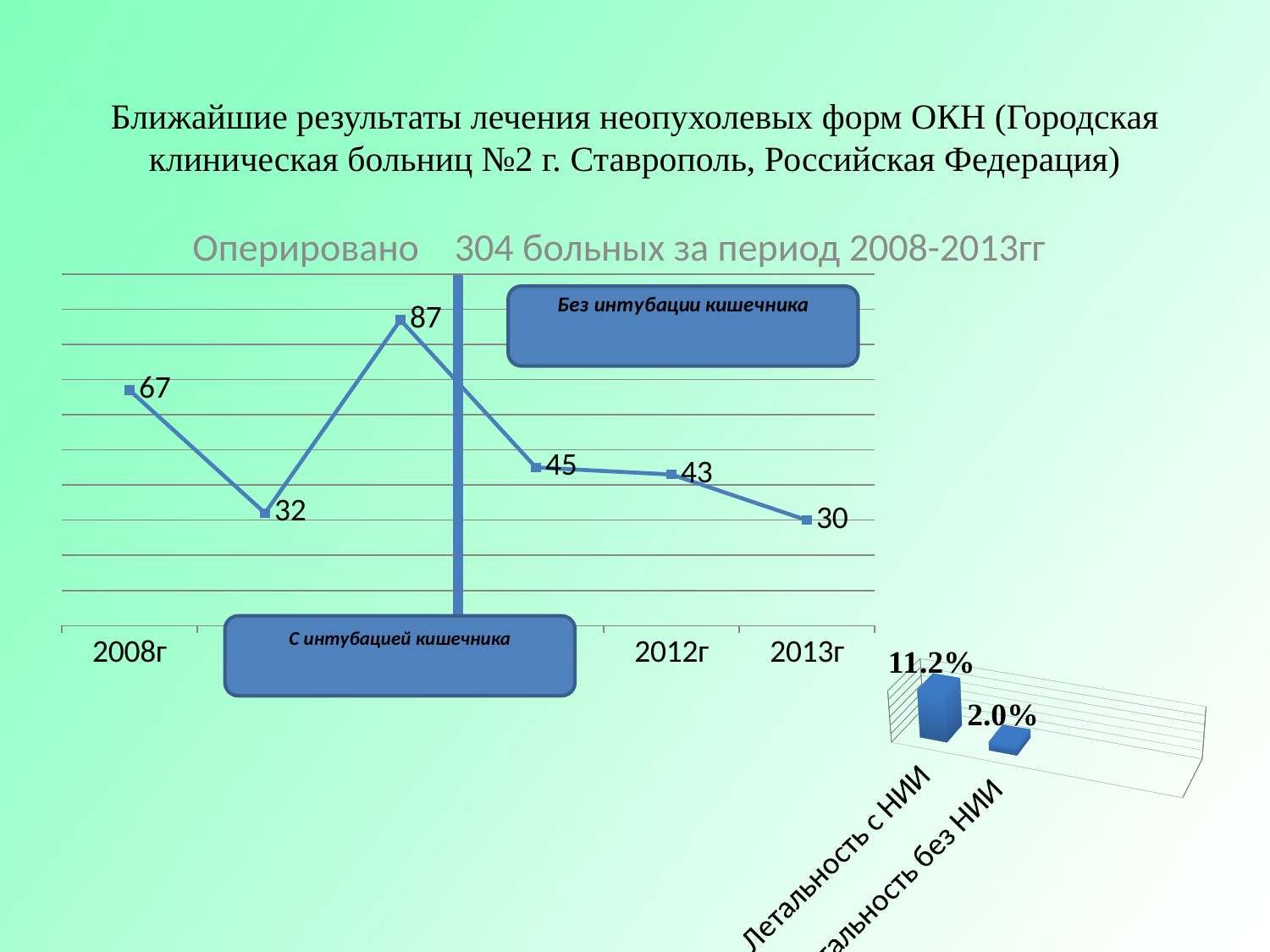
In the line chart titled 'Оперировано 304 больных за период 2008-2013гг', what is the highest value plotted? 87 In the line chart titled 'Оперировано 304 больных за период 2008-2013гг', what is the value for 2013г? 30 How many data points are plotted in the line chart titled 'Оперировано 304 больных за период 2008-2013гг'? 6 In the line chart titled 'Оперировано 304 больных за период 2008-2013гг', what is the difference between the values for 2008г and 2013г? 37 In the line chart titled 'Оперировано 304 больных за период 2008-2013гг', which year has the lowest value? 2013г In the line chart titled 'Оперировано 304 больных за период 2008-2013гг', what is the value for 2008г? 67 In the small chart at the bottom right, what is the difference between the two values shown, 11.2% and 2.0%? 9.2% What kind of chart is the small chart at the bottom right of the slide? Bar chart In the line chart titled 'Оперировано 304 больных за период 2008-2013гг', what is the value for 2012г? 43 In the line chart titled 'Оперировано 304 больных за период 2008-2013гг', which is larger, the value for 2012г or for 2013г? 2012г What kind of chart is the large chart titled 'Оперировано 304 больных за период 2008-2013гг'? Line chart In the small chart at the bottom right, what is the value for 'Летальность с НИИ'? 11.2%